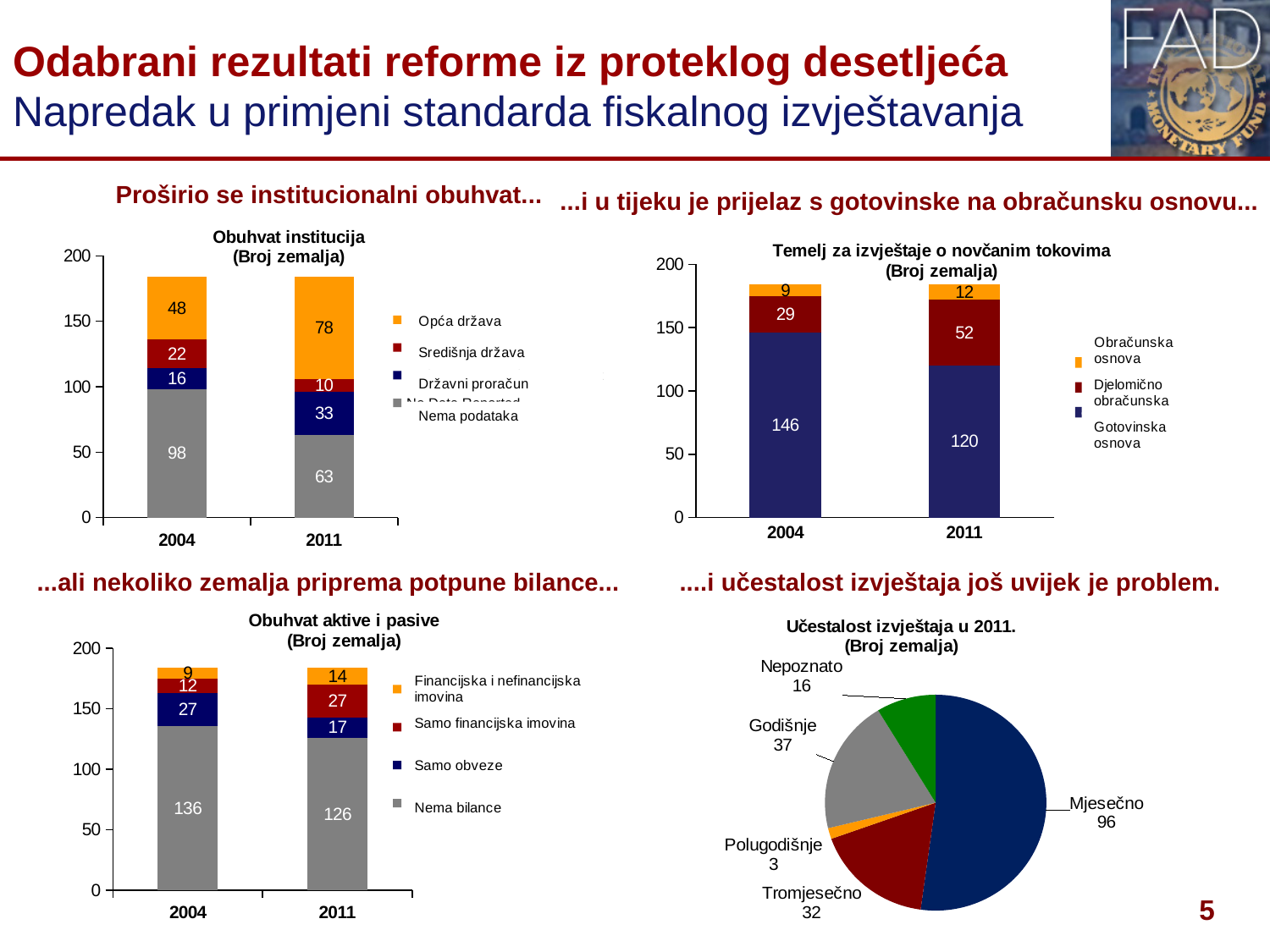
In the 'Obuhvat institucija' chart, what is the value for Opća država in 2011? 78 In the 'Učestalost izvještaja u 2011.' pie chart, what is the value for Godišnje? 37 In the 'Obuhvat aktive i pasive' chart, what is the value for Samo obveze in 2011? 17 What kind of chart is 'Učestalost izvještaja u 2011.'? Pie chart In the 'Temelj za izvještaje o novčanim tokovima' chart, which year has the larger Djelomično obračunska value, 2004 or 2011? 2011 In the 'Temelj za izvještaje o novčanim tokovima' chart, what is the value for Gotovinska osnova in 2004? 146 In the 'Temelj za izvještaje o novčanim tokovima' chart, how many series does the legend list? 3 In the 'Obuhvat aktive i pasive' chart, what is the total of the stacked bar for 2011? 184 In the 'Učestalost izvještaja u 2011.' pie chart, which category is the smallest? Polugodišnje In the 'Obuhvat institucija' chart, what is the difference between the Nema podataka values for 2004 and 2011? 35 In the 'Učestalost izvještaja u 2011.' pie chart, how many categories are shown? 5 In the 'Obuhvat institucija' chart, what is the total of the stacked bar for 2004? 184